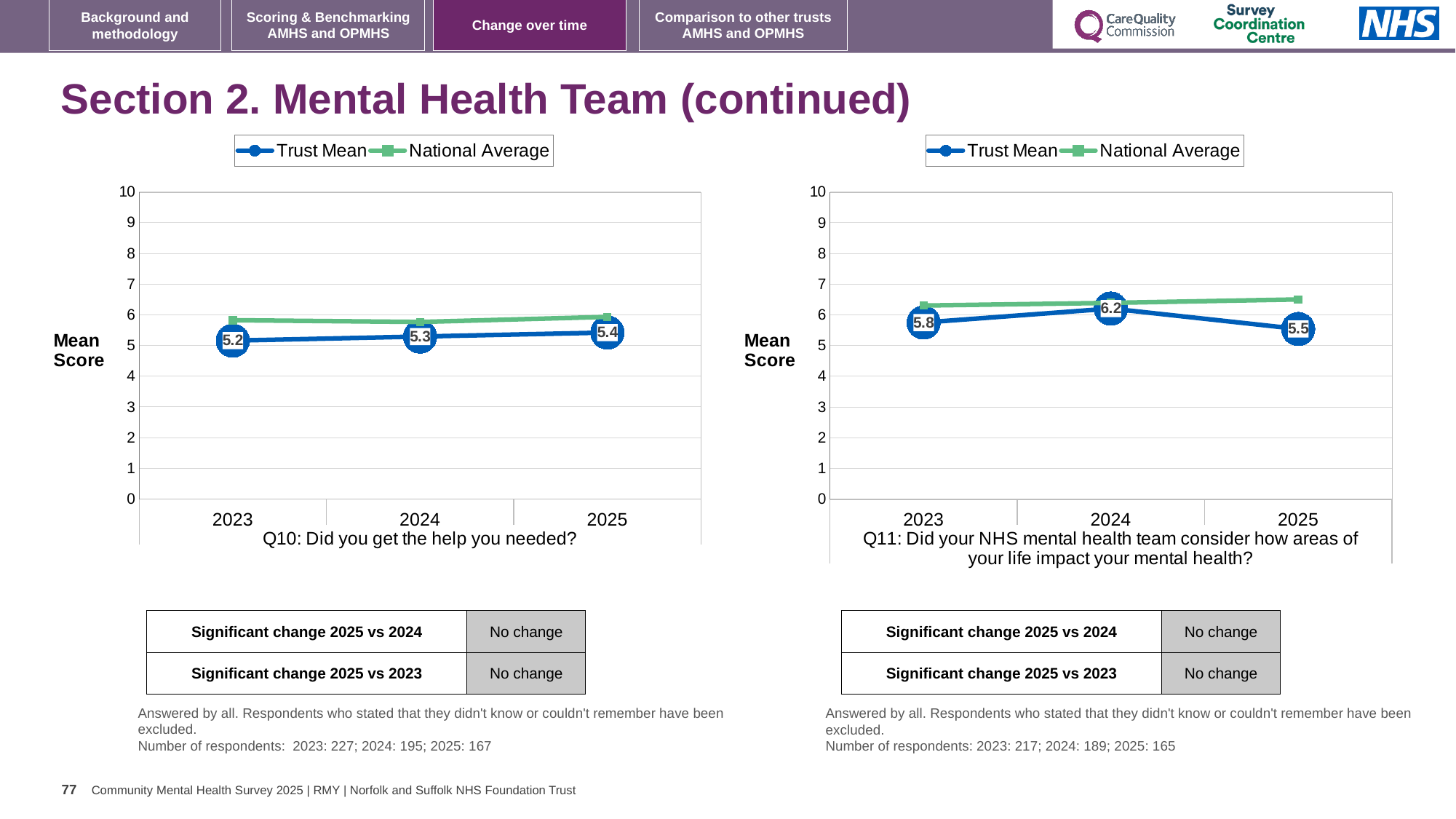
On the Q10 chart, what is the Trust Mean for 2023? 5.2 On the Q10 chart, what is the Trust Mean for 2025? 5.4 How many series does the legend of the Q11 chart list? 2 On the Q11 chart, what is the Trust Mean for 2025? 5.5 On the Q10 chart, does the Trust Mean rise or fall from 2023 to 2025? rise What kind of chart is the Q10 chart? Line chart On the Q11 chart, which year has the highest Trust Mean? 2024 On the Q11 chart, what is the difference between the Trust Mean for 2024 and 2025? 0.7 On the Q10 chart, is the National Average for 2025 greater or less than 5? greater On the Q11 chart, what is the Trust Mean for 2024? 6.2 On the Q10 chart, which year has the lowest Trust Mean? 2023 On the Q11 chart, is the Trust Mean for 2023 larger than the Trust Mean for 2025? Yes